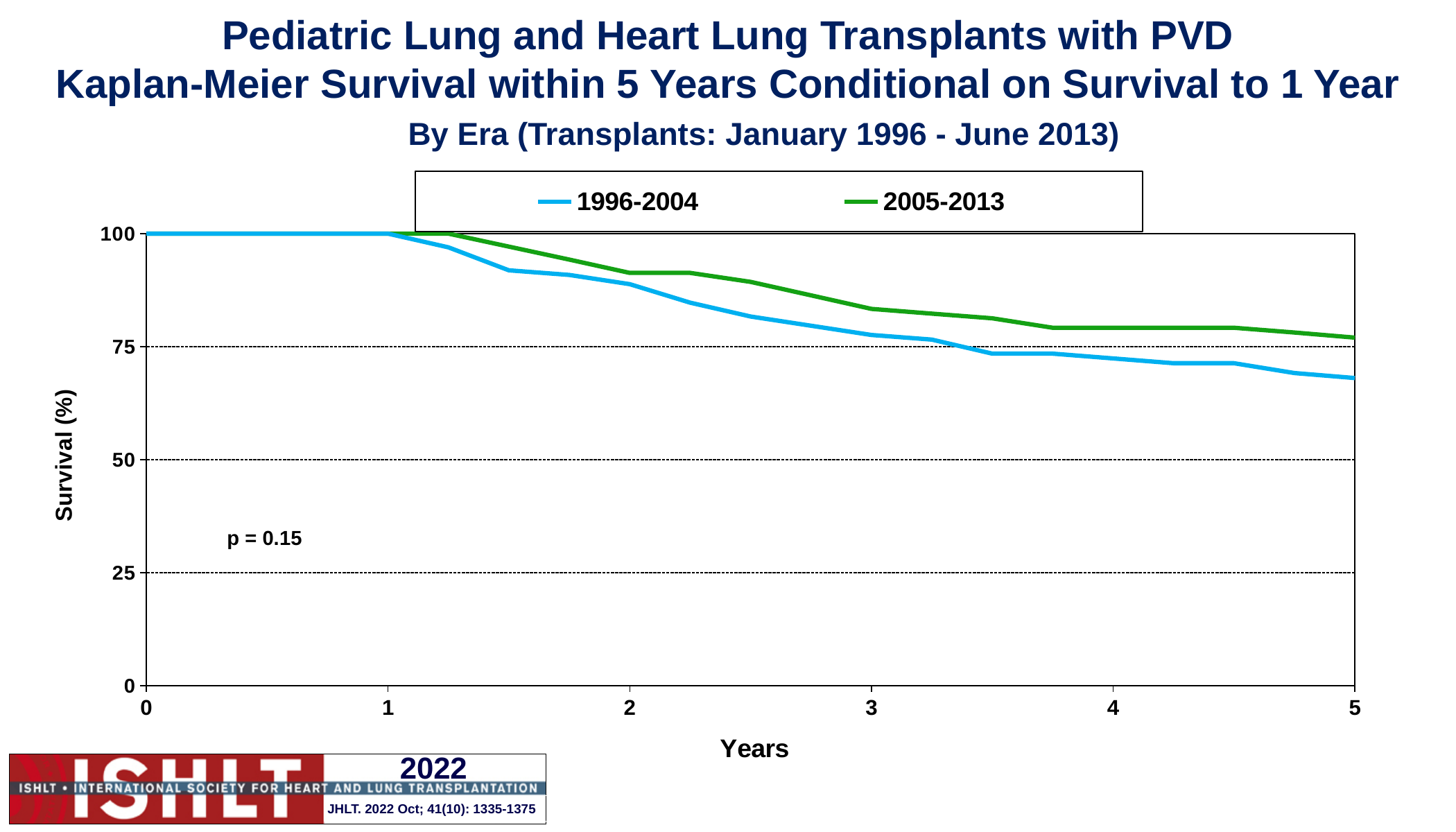
Is the survival value for the 2005-2013 era at year 3 greater or less than 75? greater Is the survival value for the 1996-2004 era at year 4 greater or less than 75? less Is the survival value for the 2005-2013 era at year 5 greater or less than 75? greater What is the p-value shown on the chart? p = 0.15 What kind of chart is shown on the slide? line chart How many series does the legend list? 2 Does survival for the 1996-2004 era rise or fall from year 1 to year 5? fall Which era has the higher survival at year 5, 1996-2004 or 2005-2013? 2005-2013 What is the survival value for both eras at year 1? 100 What is the label of the y axis? Survival (%) Which two eras are listed in the legend? 1996-2004 and 2005-2013